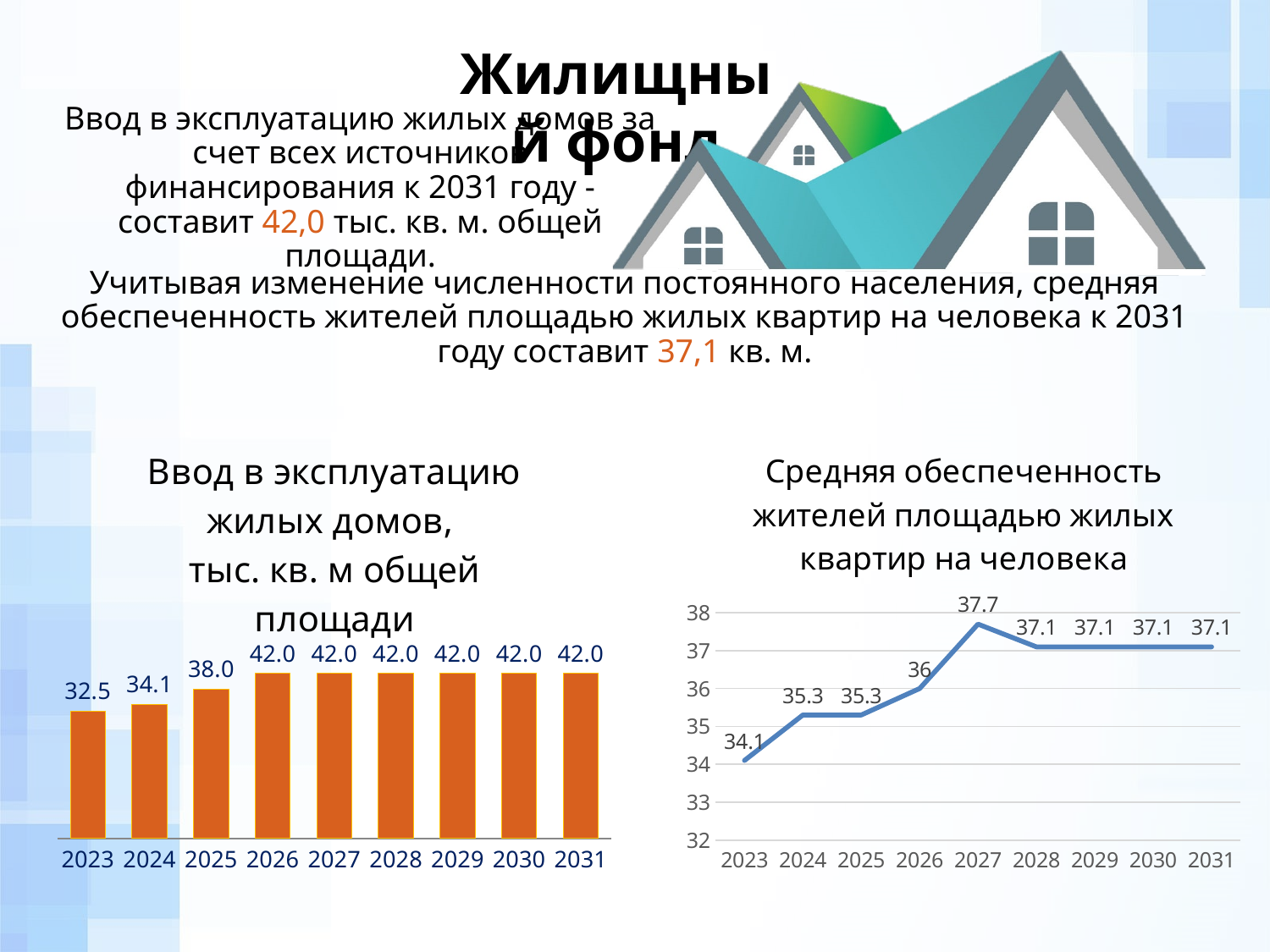
In the right chart (Средняя обеспеченность жителей площадью жилых квартир на человека), what is the value for 2026? 36 In the right chart (Средняя обеспеченность жителей площадью жилых квартир на человека), which is larger: the value for 2024 or the value for 2027? 2027 In the left chart (Ввод в эксплуатацию жилых домов), which year has the lowest value? 2023 In the right chart (Средняя обеспеченность жителей площадью жилых квартир на человека), what is the value for 2027? 37.7 In the left chart (Ввод в эксплуатацию жилых домов), what is the difference between the values for 2025 and 2024? 3.9 In the left chart (Ввод в эксплуатацию жилых домов), how many years are shown on the x axis? 9 In the left chart (Ввод в эксплуатацию жилых домов), what is the value for 2025? 38.0 What kind of chart is the right chart (Средняя обеспеченность жителей площадью жилых квартир на человека)? line chart In the right chart (Средняя обеспеченность жителей площадью жилых квартир на человека), which year has the highest value? 2027 In the left chart (Ввод в эксплуатацию жилых домов), what is the value for 2023? 32.5 In the right chart (Средняя обеспеченность жителей площадью жилых квартир на человека), what is the difference between the values for 2027 and 2023? 3.6 What kind of chart is the left chart (Ввод в эксплуатацию жилых домов)? bar chart